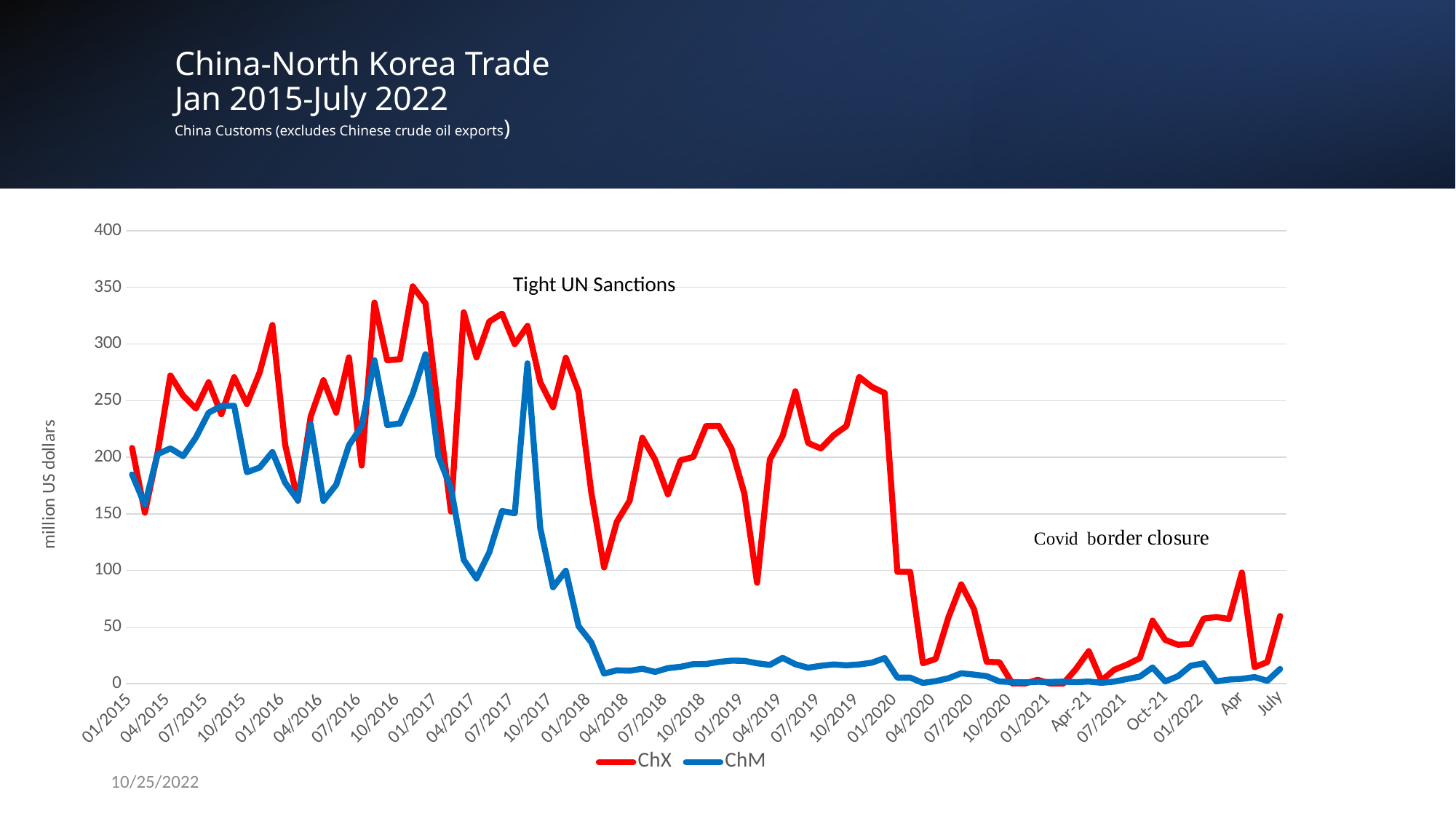
What kind of chart is shown on the slide? line chart Is the value for ChM at 04/2018 greater or less than 50? less How many series does the legend list? 2 What is the label on the vertical axis of the chart? million US dollars Which series reaches the highest peak value over the whole period? ChX Does the ChX series rise or fall between 10/2019 and 04/2020? fall Is the value for ChX at 10/2018 greater or less than 200? greater At 04/2018, which series has the larger value, ChX or ChM? ChX Which series is drawn in red in the chart? ChX Is the value for ChM at 01/2020 greater or less than 50? less At 10/2016, which series has the larger value, ChX or ChM? ChX